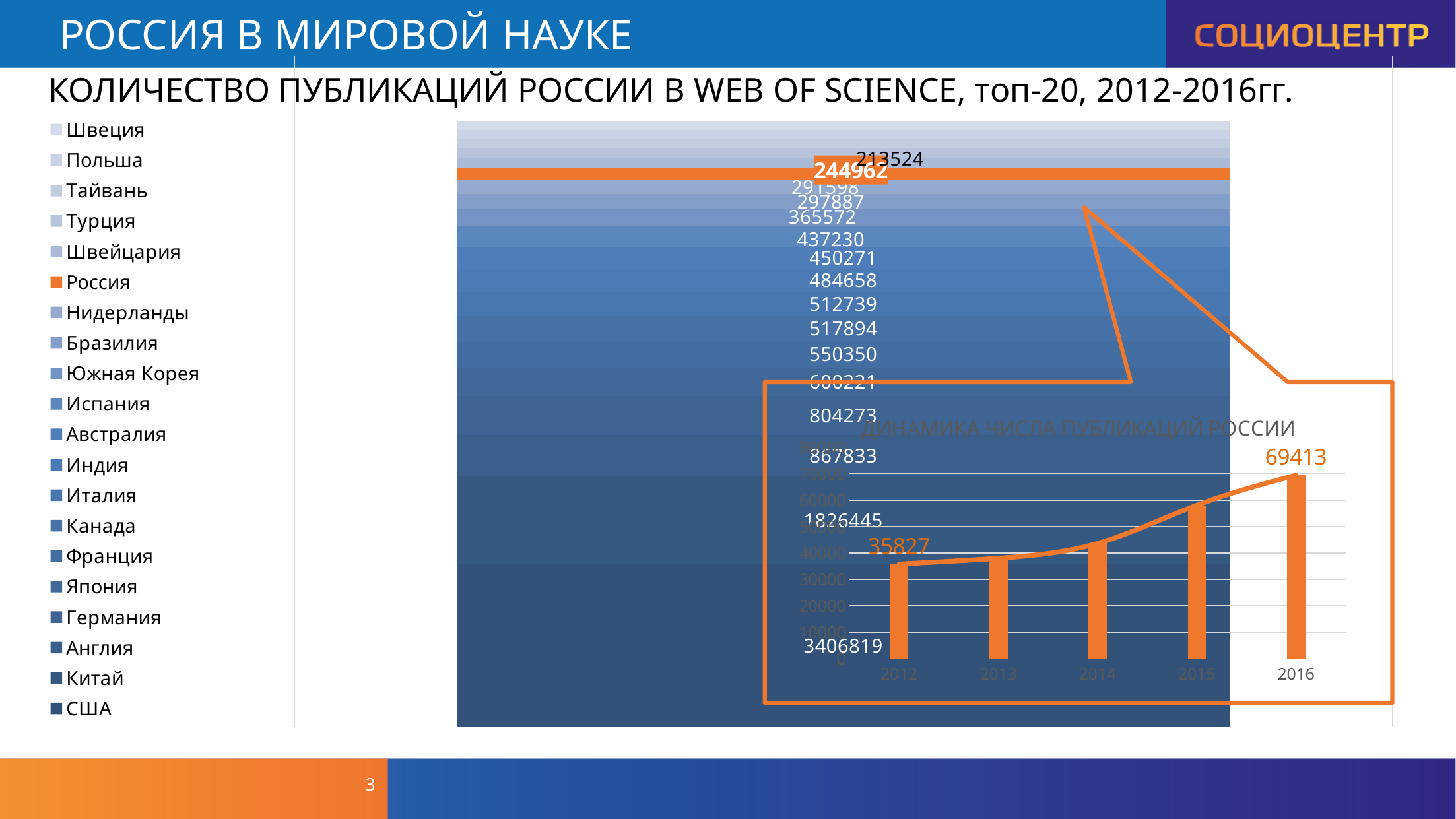
On the main chart 'КОЛИЧЕСТВО ПУБЛИКАЦИЙ РОССИИ В WEB OF SCIENCE', how many countries does the legend list? 20 On the inset chart 'ДИНАМИКА ЧИСЛА ПУБЛИКАЦИЙ РОССИИ', which year has the lowest value? 2012 On the inset chart 'ДИНАМИКА ЧИСЛА ПУБЛИКАЦИЙ РОССИИ', what is the difference between the 2016 and 2012 values? 33586 On the inset chart 'ДИНАМИКА ЧИСЛА ПУБЛИКАЦИЙ РОССИИ', what is the value for 2012? 35827 On the inset chart 'ДИНАМИКА ЧИСЛА ПУБЛИКАЦИЙ РОССИИ', do the values rise or fall from 2012 to 2016? rise What kind of chart is the inset chart 'ДИНАМИКА ЧИСЛА ПУБЛИКАЦИЙ РОССИИ'? combination bar and line chart On the main chart 'КОЛИЧЕСТВО ПУБЛИКАЦИЙ РОССИИ В WEB OF SCIENCE', what is the value for Россия (the orange segment)? 244962 On the inset chart 'ДИНАМИКА ЧИСЛА ПУБЛИКАЦИЙ РОССИИ', what is the value for 2016? 69413 On the inset chart 'ДИНАМИКА ЧИСЛА ПУБЛИКАЦИЙ РОССИИ', is the value for 2015 greater or less than 50000? greater On the inset chart 'ДИНАМИКА ЧИСЛА ПУБЛИКАЦИЙ РОССИИ', is the value for 2014 greater or less than 40000? greater On the inset chart 'ДИНАМИКА ЧИСЛА ПУБЛИКАЦИЙ РОССИИ', which year has the highest value? 2016 On the inset chart 'ДИНАМИКА ЧИСЛА ПУБЛИКАЦИЙ РОССИИ', how many years are shown on the x axis? 5